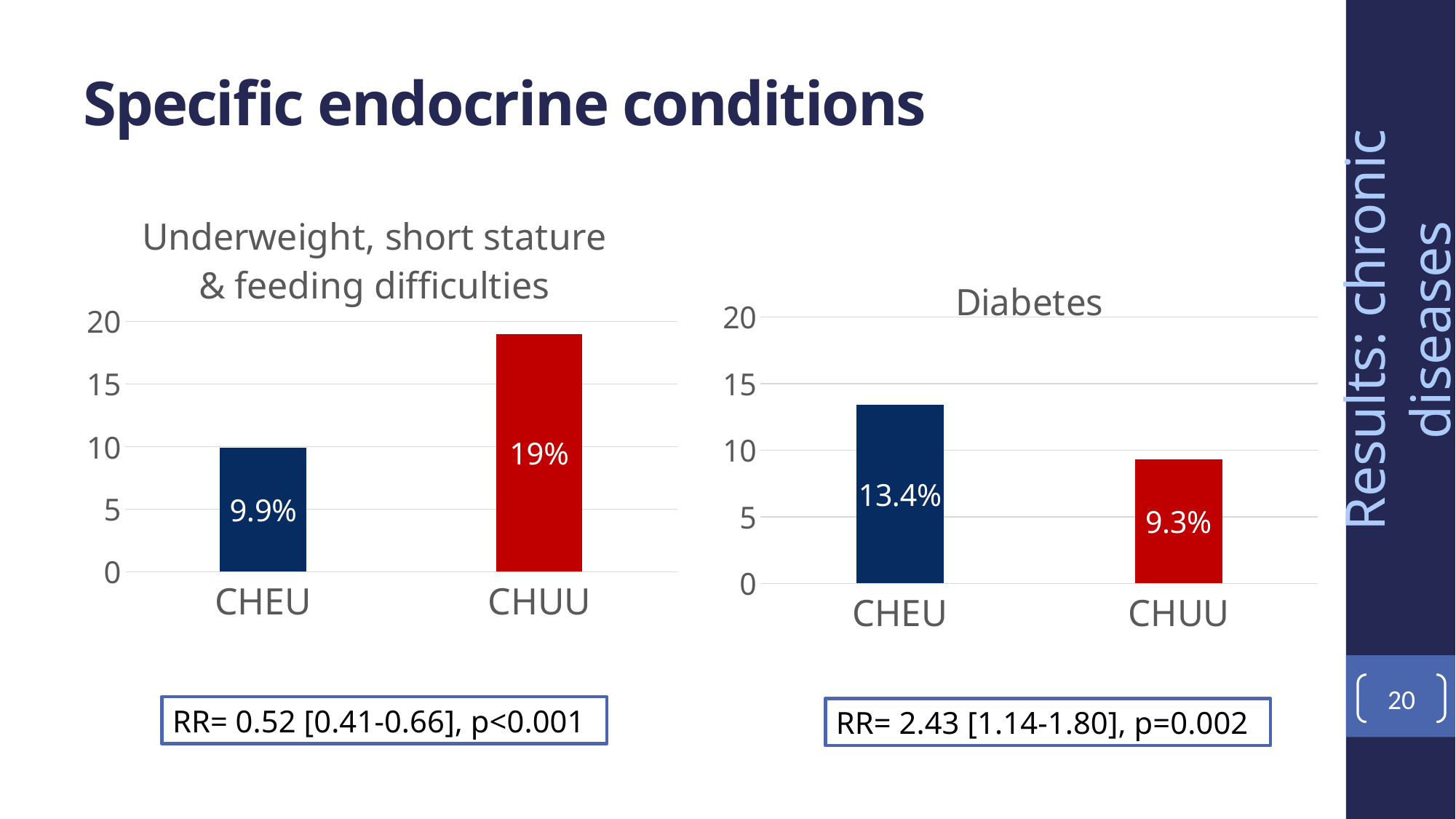
In the 'Underweight, short stature & feeding difficulties' chart, what is the value for CHEU? 9.9% In the 'Underweight, short stature & feeding difficulties' chart, is the value for CHEU greater or less than 15? less What kind of chart is the 'Diabetes' chart? Bar chart In the 'Diabetes' chart, what is the value for CHEU? 13.4% In the 'Underweight, short stature & feeding difficulties' chart, what is the value for CHUU? 19% How many categories are shown in the 'Diabetes' chart? 2 In the 'Diabetes' chart, what is the difference between the CHEU and CHUU values? 4.1% In the 'Underweight, short stature & feeding difficulties' chart, what is the difference between the CHUU and CHEU values? 9.1% In the 'Diabetes' chart, what is the value for CHUU? 9.3% In the 'Underweight, short stature & feeding difficulties' chart, which group has the higher value? CHUU In the 'Diabetes' chart, which group has the lower value? CHUU In the 'Diabetes' chart, is the value for CHEU greater or less than 10? greater